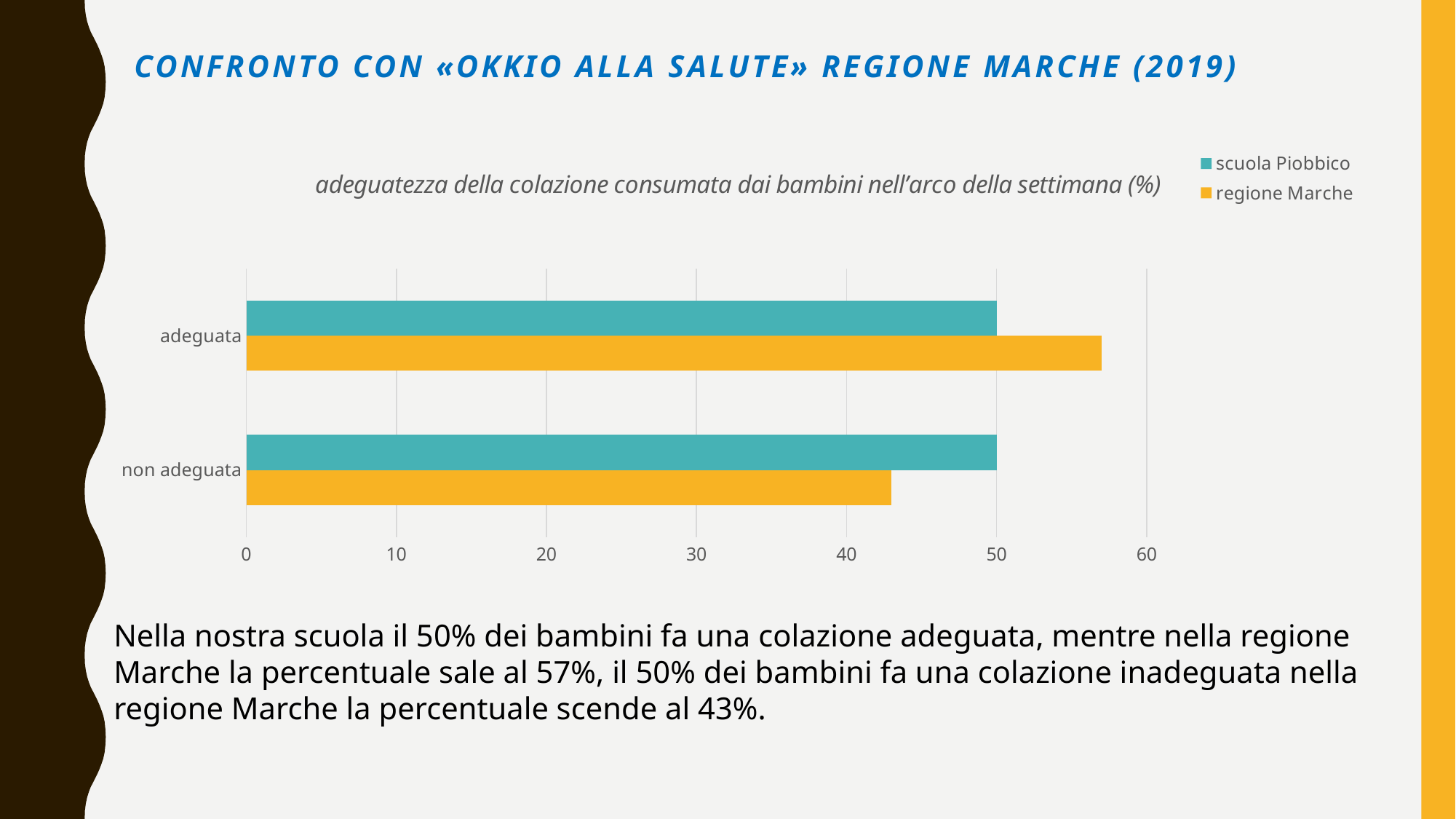
In the 'non adeguata' category, which series has the larger value: scuola Piobbico or regione Marche? scuola Piobbico What kind of chart is shown on the slide? bar chart Is the value for regione Marche in the 'non adeguata' category greater or less than 50? less How many series does the legend list? 2 In the 'adeguata' category, which series has the larger value: scuola Piobbico or regione Marche? regione Marche Which colour represents the 'regione Marche' series in the chart? yellow/orange How many categories are shown on the vertical axis? 2 What is the value for scuola Piobbico in the 'non adeguata' category? 50 According to the slide, what percentage of children in regione Marche have an inadequate ('non adeguata') breakfast? 43% What is the value for scuola Piobbico in the 'adeguata' category? 50 Is the value for regione Marche in the 'adeguata' category greater or less than 50? greater According to the slide, what percentage of children in regione Marche have an adequate ('adeguata') breakfast? 57%